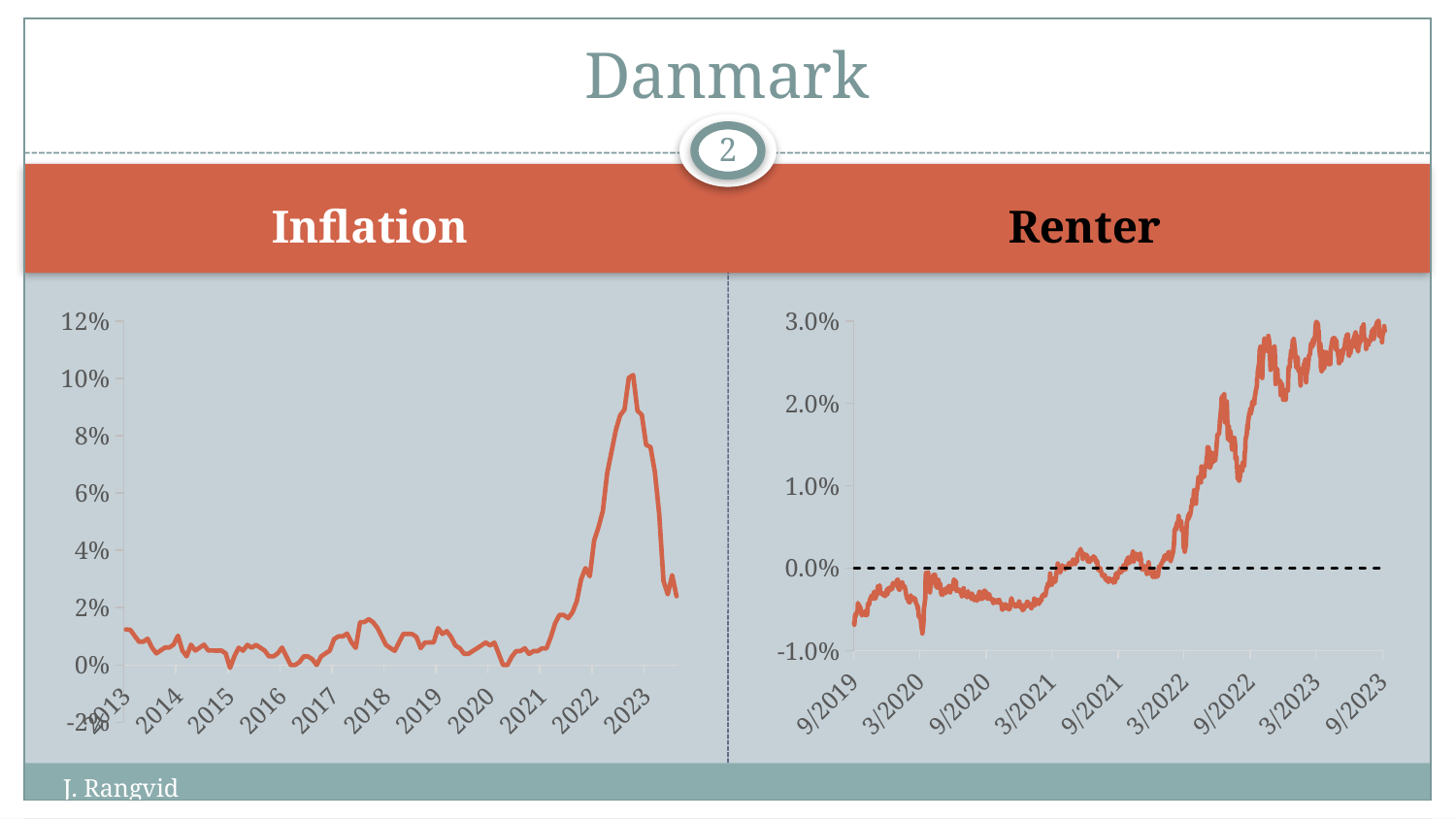
In the Renter chart, is the value at 9/2019 greater or less than 0.0%? less What kind of chart is the Renter chart on the right? line chart What is the title of the chart on the right side of the slide? Renter In the Renter chart, is the value at 9/2023 greater or less than 2.0%? greater In the Inflation chart, is the value at the end of the series in 2023 greater or less than 4%? less How many date labels are shown on the x axis of the Renter chart? 9 In the Renter chart, do the values overall rise or fall from 9/2019 to 9/2023? rise How many year labels are shown on the x axis of the Inflation chart? 11 What kind of chart is the Inflation chart on the left? line chart In the Inflation chart, do the values rise or fall between 2021 and late 2022? rise